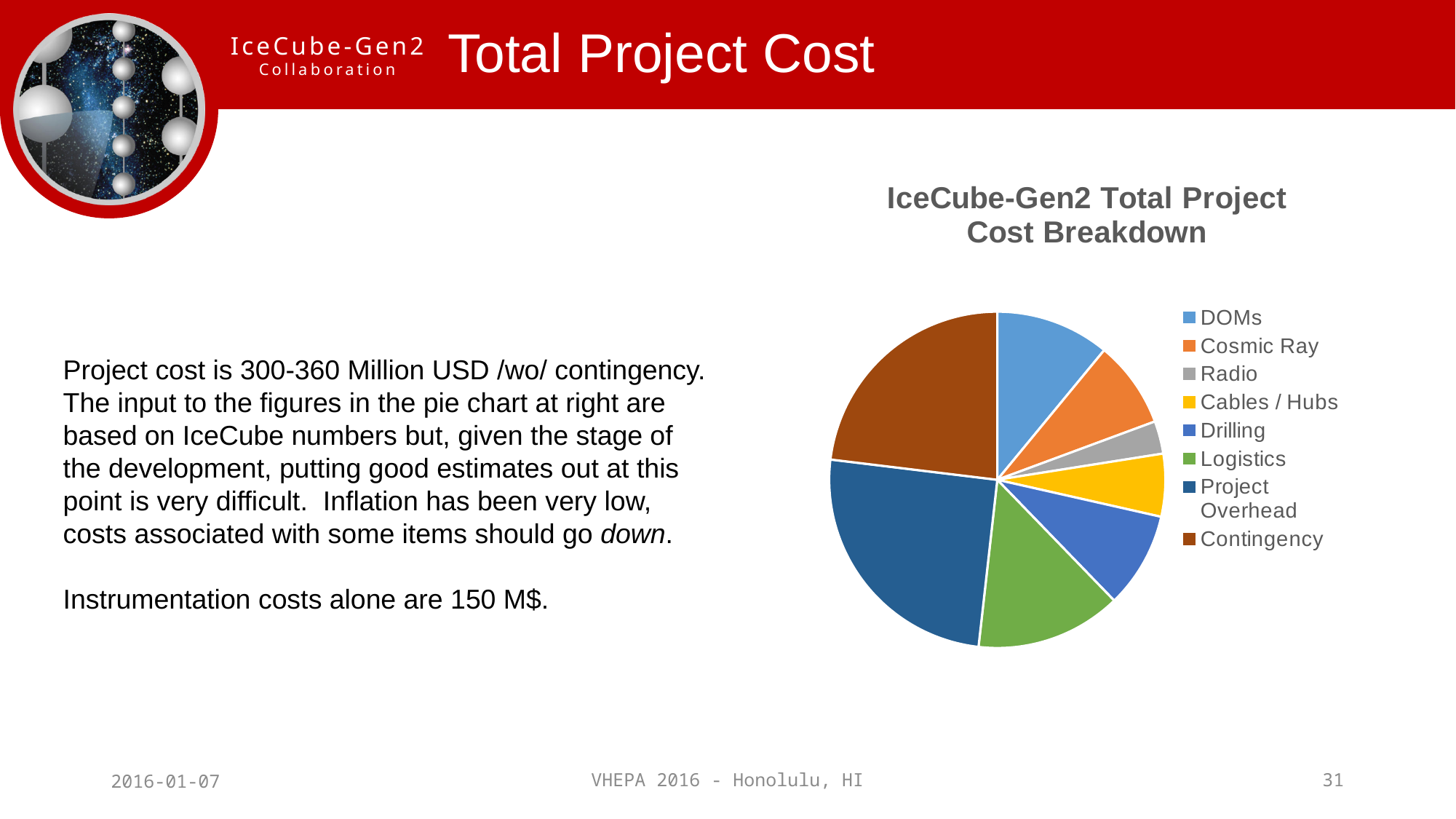
How many entries does the legend of the pie chart list? 8 Which category has the smallest slice in the pie chart? Radio Which slice is larger in the pie chart, Logistics or Drilling? Logistics What kind of chart is shown on the slide? Pie chart How many slices does the pie chart have? 8 Which slice is larger in the pie chart, DOMs or Radio? DOMs Which slice is larger in the pie chart, Project Overhead or Logistics? Project Overhead What colour is the Contingency slice in the pie chart? Brown What is the title of the pie chart? IceCube-Gen2 Total Project Cost Breakdown